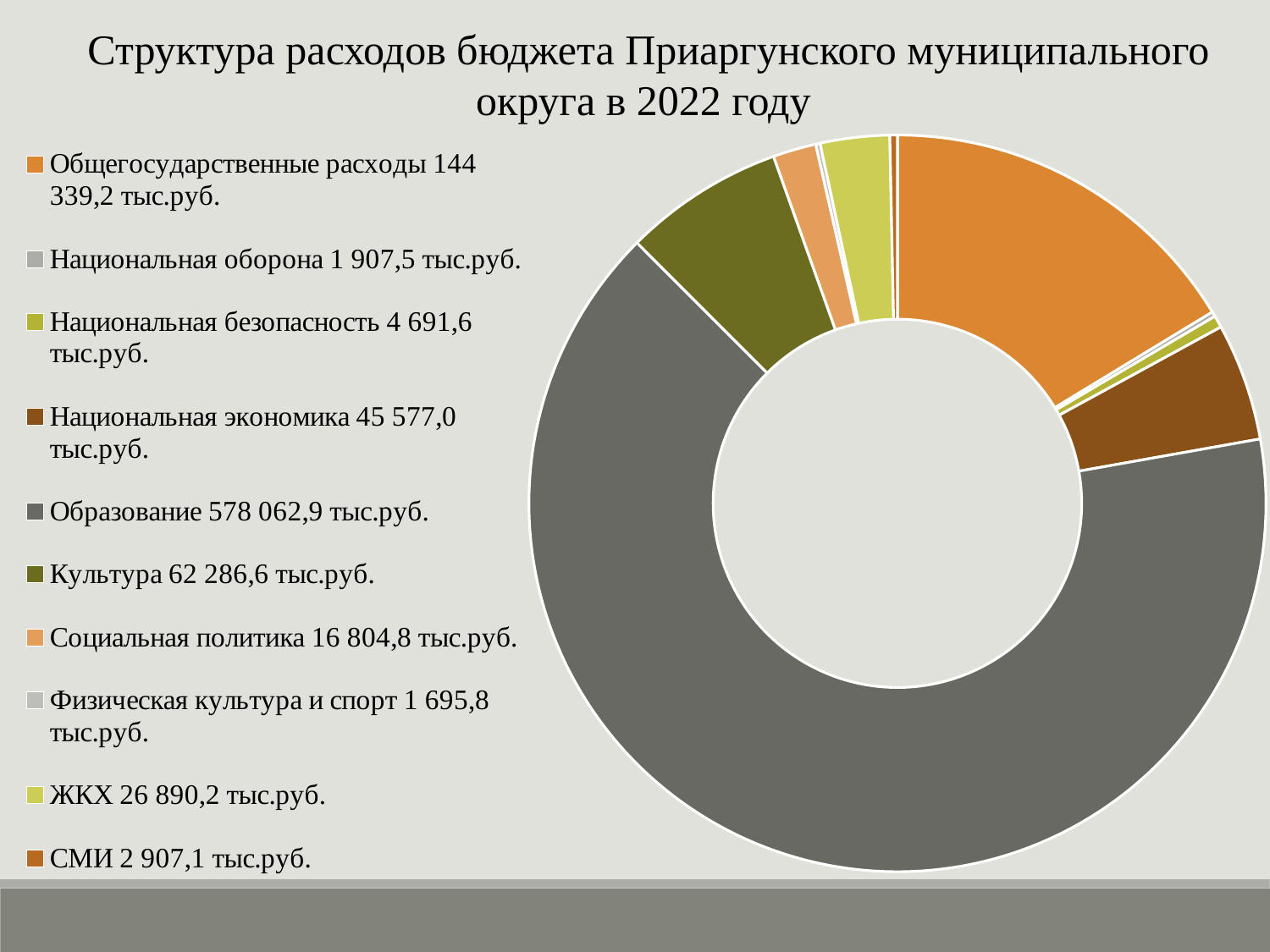
What is the value for Образование? 578 062,9 тыс.руб. What is the value for Социальная политика? 16 804,8 тыс.руб. What is the title of the chart? Структура расходов бюджета Приаргунского муниципального округа в 2022 году What is the difference between Культура and Национальная экономика? 16 709,6 тыс.руб. Which is larger, Культура or Национальная экономика? Культура How many expenditure categories does the legend list? 10 What is the value for ЖКХ? 26 890,2 тыс.руб. Which category has the largest expenditure? Образование What is the difference between Образование and Общегосударственные расходы? 433 723,7 тыс.руб. What is the value for Общегосударственные расходы? 144 339,2 тыс.руб. Which category has the smallest expenditure? Физическая культура и спорт What type of chart is shown on the slide? Doughnut chart